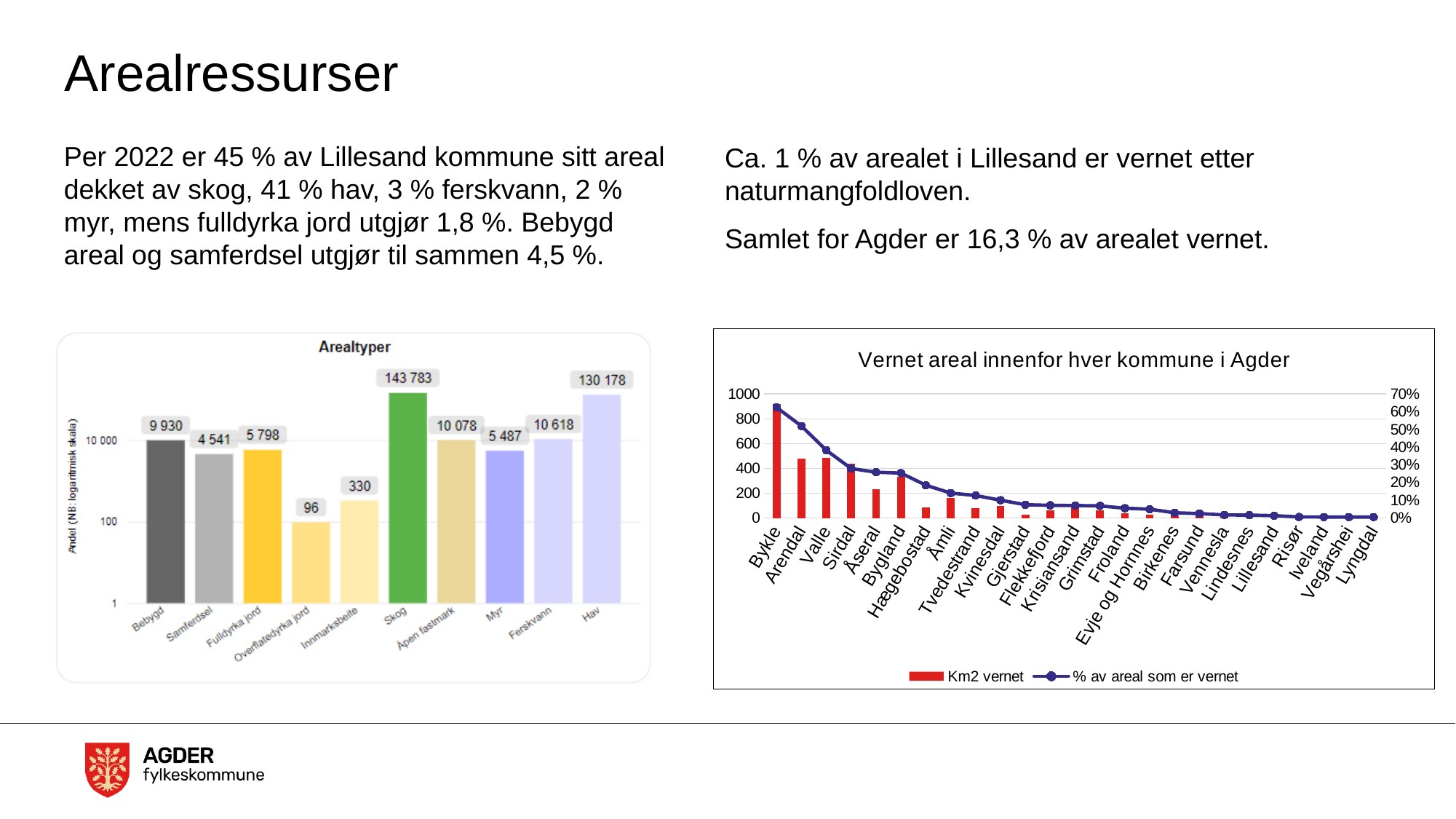
In the chart 'Vernet areal innenfor hver kommune i Agder', is the Km2 vernet value for Arendal greater or less than 600? less In the Arealtyper chart, what is the value for Skog? 143 783 How many series does the legend list in the chart 'Vernet areal innenfor hver kommune i Agder'? 2 In the Arealtyper chart, what is the value for Overflatedyrka jord? 96 In the chart 'Vernet areal innenfor hver kommune i Agder', is the Km2 vernet value for Bykle greater or less than 800? greater In the Arealtyper chart, which category has the lowest value? Overflatedyrka jord How many categories are shown in the Arealtyper chart? 10 In the Arealtyper chart, what is the value for Ferskvann? 10 618 In the chart 'Vernet areal innenfor hver kommune i Agder', do the Km2 vernet values generally rise or fall from left to right along the x axis? fall In the Arealtyper chart, which category has the highest value? Skog In the Arealtyper chart, what is the difference between the values for Skog and Hav? 13 605 In the Arealtyper chart, which is larger, the value for Bebygd or the value for Samferdsel? Bebygd